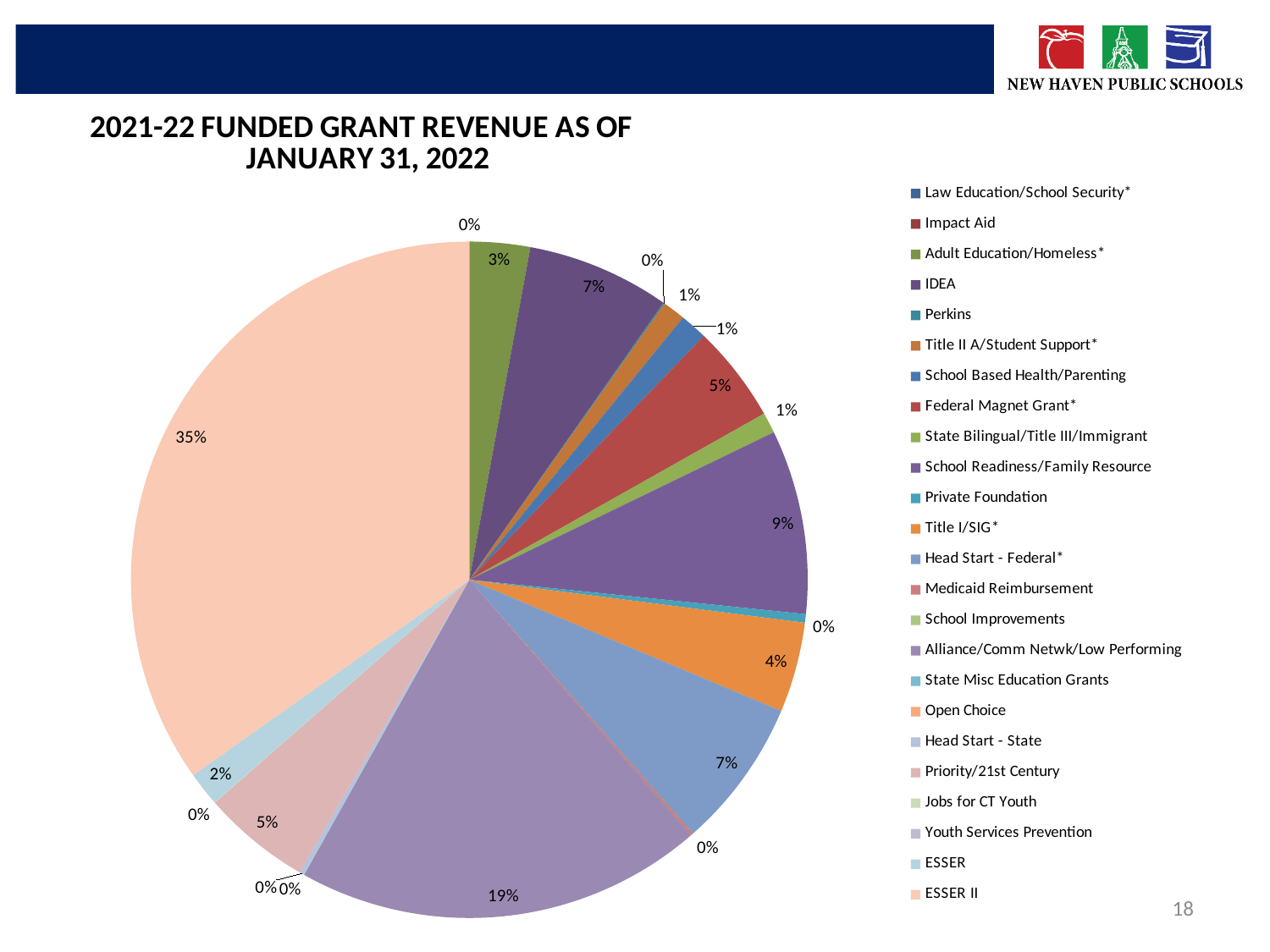
Which category has the largest slice of the pie? ESSER II Which is larger, the ESSER II slice or the Alliance/Comm Netwk/Low Performing slice? ESSER II What share of the pie does Alliance/Comm Netwk/Low Performing account for? 19% By how many percentage points does the ESSER II slice (35%) exceed the Alliance/Comm Netwk/Low Performing slice (19%)? 16 percentage points What is the value of the second-largest slice in the pie? 19% What share of the pie does ESSER II account for? 35% What type of chart is shown on the slide? Pie chart What is the title of the chart? 2021-22 FUNDED GRANT REVENUE AS OF JANUARY 31, 2022 How many slices are labeled 7%? 2 What is the first entry listed in the legend? Law Education/School Security* How many categories does the legend list? 24